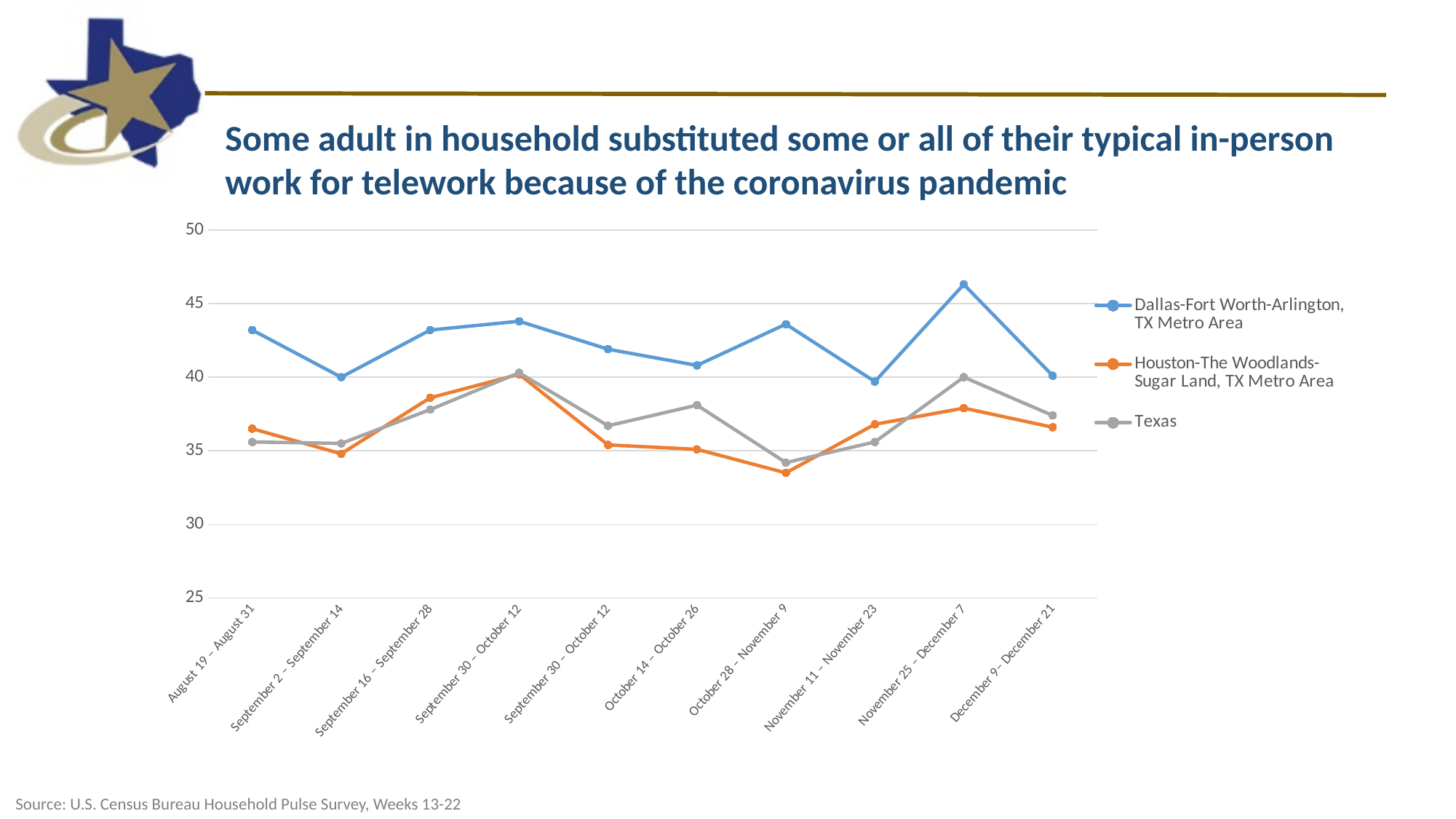
Is the value for Dallas-Fort Worth-Arlington, TX Metro Area in November 25 – December 7 greater or less than 45? greater Is the value for Houston-The Woodlands-Sugar Land, TX Metro Area in September 16 – September 28 greater or less than 35? greater Does the Dallas-Fort Worth-Arlington, TX Metro Area series rise or fall from November 25 – December 7 to December 9 – December 21? fall In which period does the Dallas-Fort Worth-Arlington, TX Metro Area series reach its highest value? November 25 – December 7 What type of chart is shown on the slide? line chart How many series does the legend list? 3 How many time periods are plotted along the x axis? 10 In which period does the Texas series reach its lowest value? October 28 – November 9 Is the value for Houston-The Woodlands-Sugar Land, TX Metro Area in October 28 – November 9 greater or less than 35? less In which period does the Houston-The Woodlands-Sugar Land, TX Metro Area series reach its lowest value? October 28 – November 9 In August 19 – August 31, which series has the higher value: Dallas-Fort Worth-Arlington, TX Metro Area or Houston-The Woodlands-Sugar Land, TX Metro Area? Dallas-Fort Worth-Arlington, TX Metro Area In October 14 – October 26, which series has the higher value: Texas or Houston-The Woodlands-Sugar Land, TX Metro Area? Texas